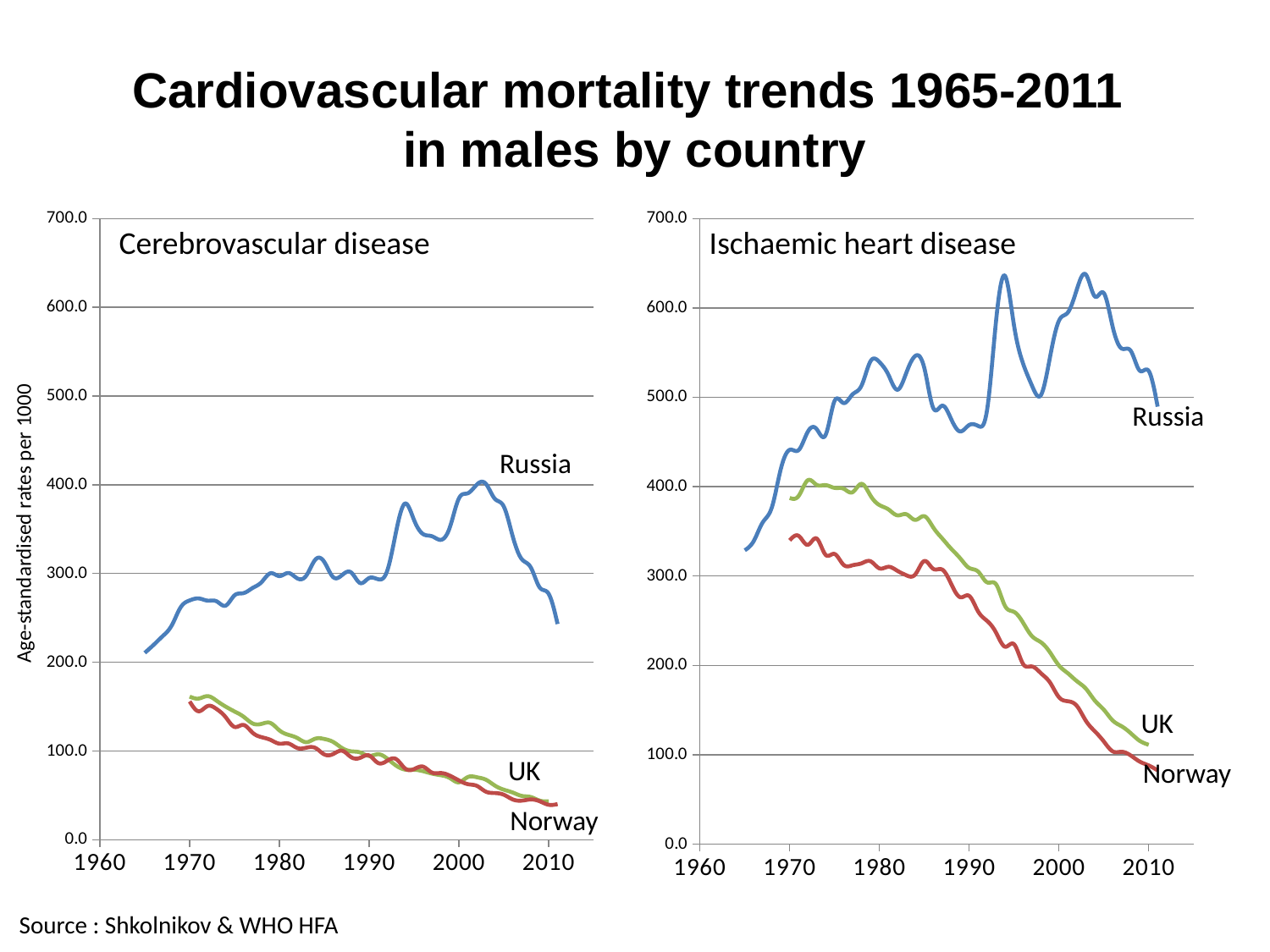
On the Ischaemic heart disease chart, is the peak value for Russia greater or less than 600? greater On the Cerebrovascular disease chart, does the mortality rate for the UK rise or fall from 1970 to 2010? Fall On the Cerebrovascular disease chart, which country has the highest mortality rate throughout the period? Russia On the Ischaemic heart disease chart, which is higher in 1990, Russia or the UK? Russia On the Cerebrovascular disease chart, is the value for Norway in 2010 greater or less than 100? less On the Cerebrovascular disease chart, is the value for the UK in 1970 greater or less than 100? greater How many countries are plotted on the Ischaemic heart disease chart? 3 What kind of chart is the Cerebrovascular disease chart? Line chart On the Ischaemic heart disease chart, does the mortality rate for Norway rise or fall from 1970 to 2010? Fall What is the y-axis label on the Cerebrovascular disease chart? Age-standardised rates per 1000 On the Ischaemic heart disease chart, which country has the highest mortality rate in 2000? Russia